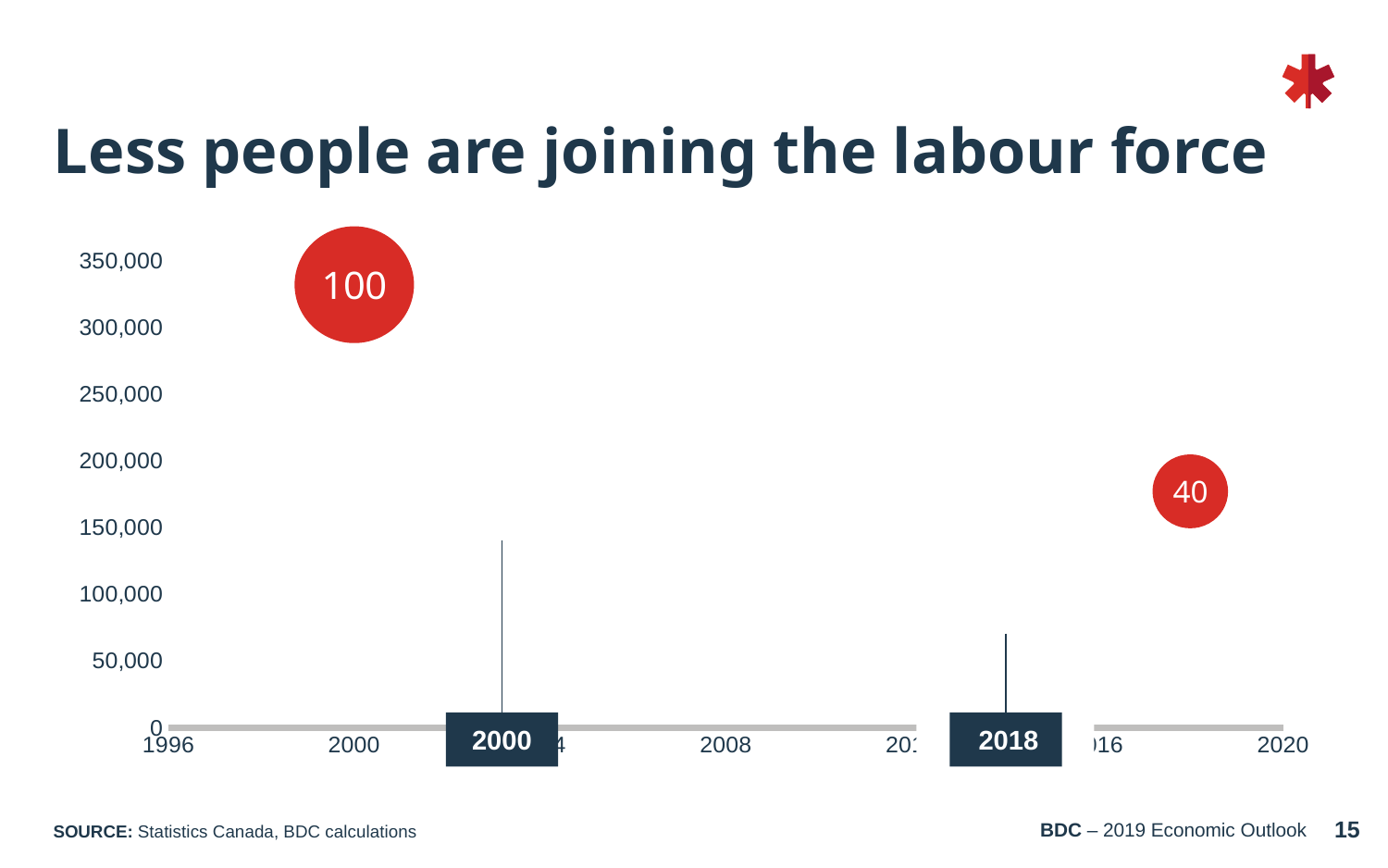
Is the value for 2018 greater or less than 50,000? greater Is the value for 2000 greater or less than 200,000? greater What is the highest value shown on the vertical axis? 350,000 Which highlighted year has the lowest bar? 2018 Is the value for 2018 greater or less than 100,000? greater Which of the two highlighted years, 2000 or 2018, has the taller bar? 2000 What kind of chart is shown on the slide? bubble chart Do the bar values rise or fall from 2000 to 2018? fall What is the title of the slide above the chart? Less people are joining the labour force How many years are highlighted with bars on the chart? 2 Which highlighted year has the highest bar? 2000